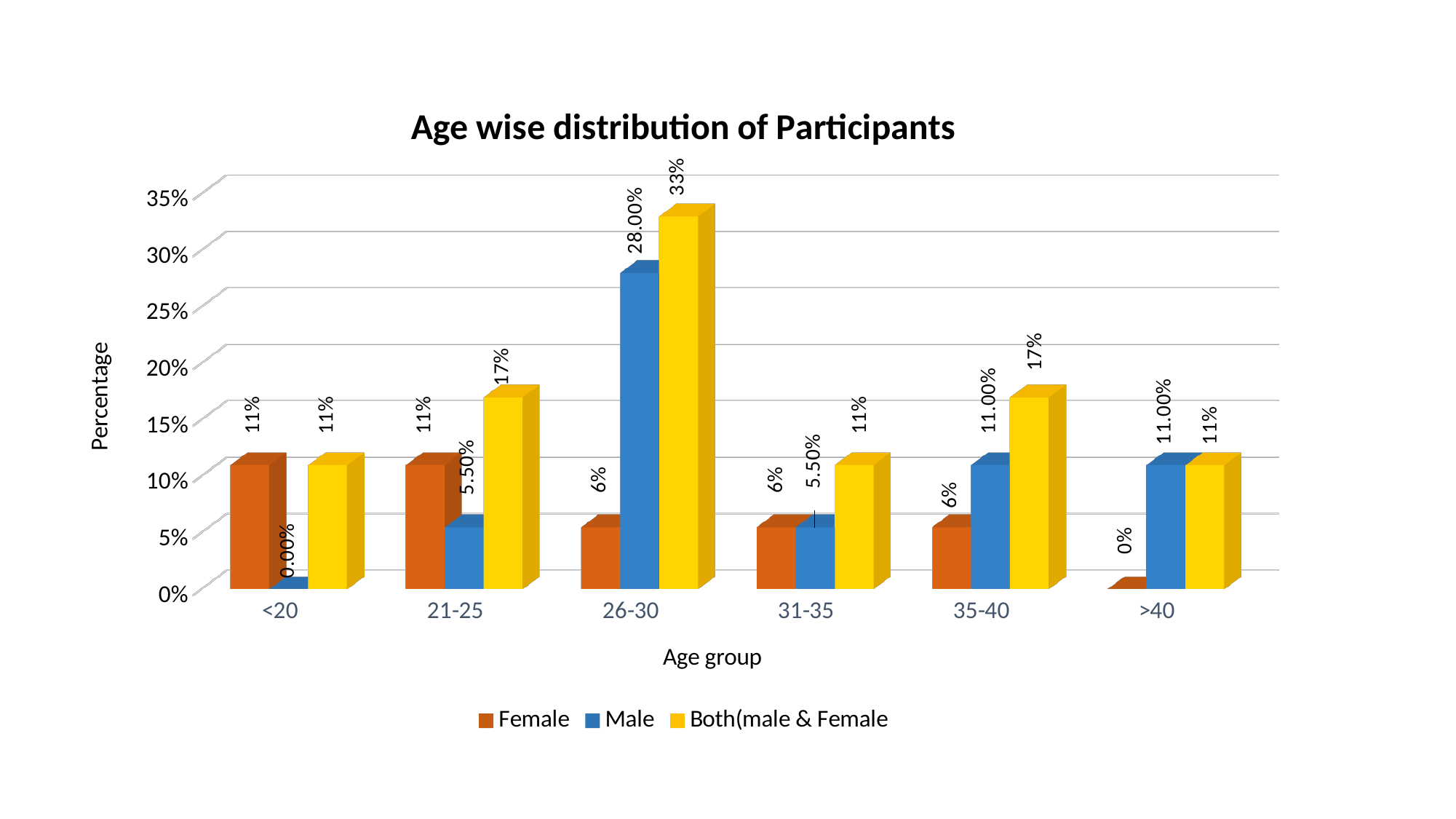
What is the Male value for the <20 age group? 0.00% Which is larger for the 21-25 age group, the Female value or the Male value? Female What kind of chart is shown on the slide? Bar chart How many series does the legend list? 3 What is the Male value for the 26-30 age group? 28.00% What is the Both(male & Female value for the 35-40 age group? 17% What is the title of the chart? Age wise distribution of Participants Which age group has the highest Both(male & Female value? 26-30 What is the difference between the Both(male & Female value and the Male value for the 26-30 age group? 5% Which age group has the lowest Female value? >40 How many age groups are shown on the x axis? 6 What is the Female value for the 21-25 age group? 11%